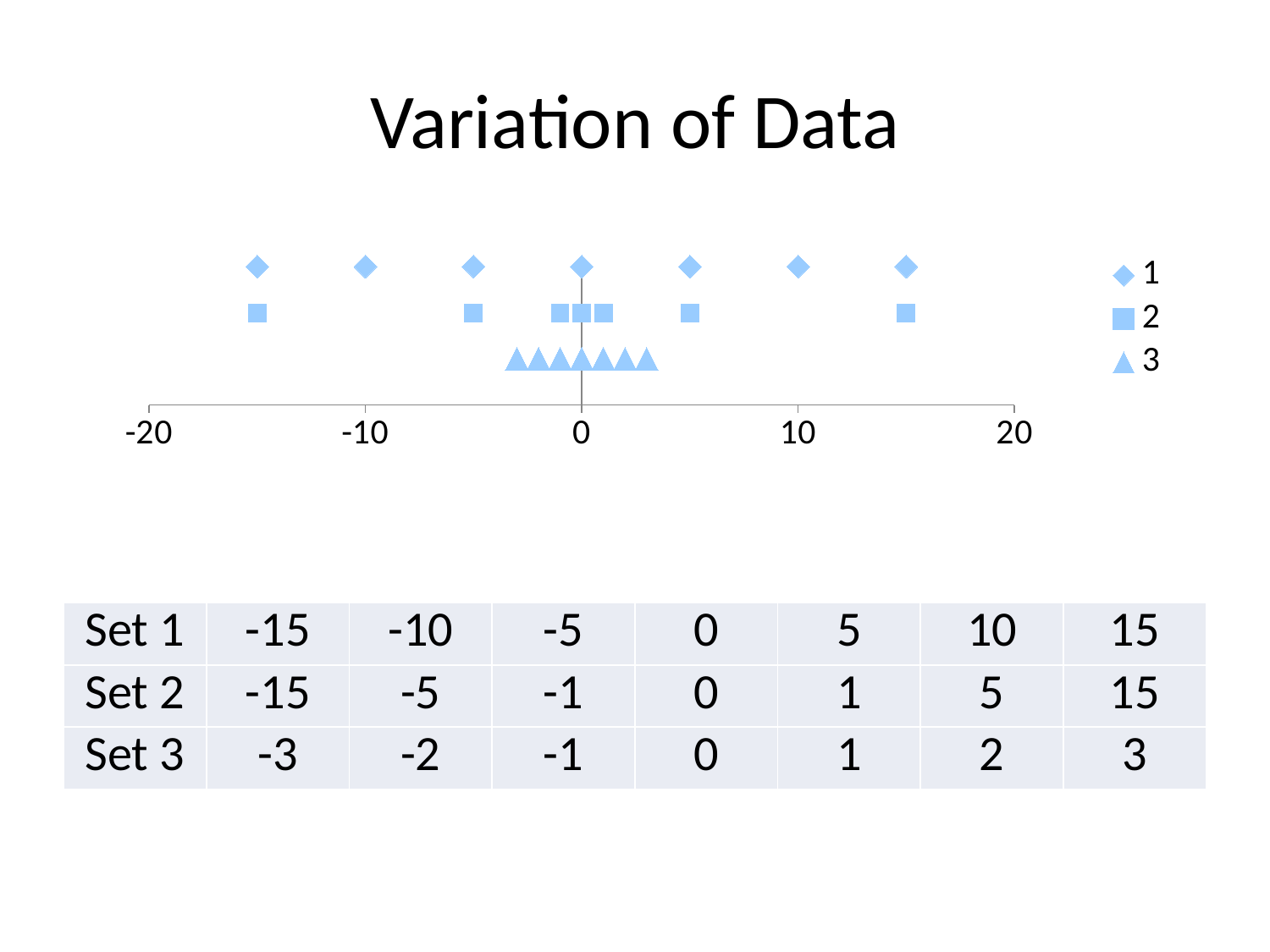
Which is larger: the rightmost point of series 1 or the rightmost point of series 3? series 1 What marker shape is used for series 2 in the chart? square What is the smallest value plotted for series 3 (Set 3)? -3 How many series does the chart legend list? 3 Is the rightmost point of series 1 greater or less than 10? greater Which series has the narrowest spread of points along the x axis? 3 What is the difference between the largest and smallest values in Set 1? 30 What is the largest value plotted for series 1 (Set 1)? 15 How many points are plotted for series 3? 7 How many points are plotted for series 1? 7 Is the leftmost point of series 3 greater or less than -10? greater What kind of chart is shown on the slide? scatter chart